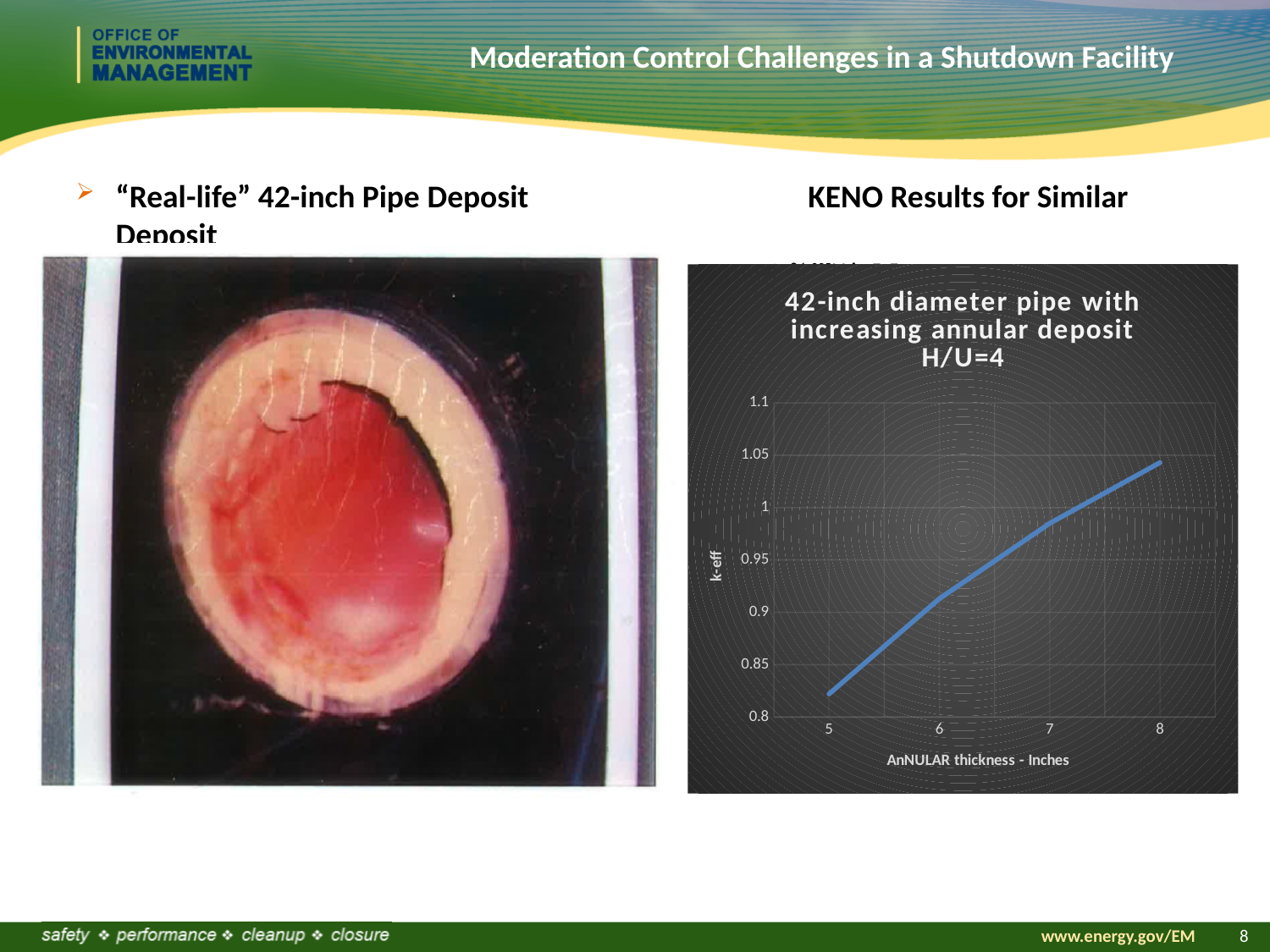
What is the label of the x axis of the chart? AnNULAR thickness - Inches Which annular thickness has the higher k-eff, 5 inches or 8 inches? 8 inches Is the k-eff value at an annular thickness of 8 inches greater or less than 1? greater What kind of chart is shown on the slide? line chart What is the title of the chart? 42-inch diameter pipe with increasing annular deposit H/U=4 Is the k-eff value at an annular thickness of 7 inches greater or less than 0.95? greater Does k-eff rise or fall as annular thickness increases from 5 to 8 inches? rise Is the k-eff value at an annular thickness of 5 inches greater or less than 0.85? less At which annular thickness shown on the x axis is k-eff highest? 8 inches What is the highest value shown on the y axis of the chart? 1.1 At which annular thickness shown on the x axis is k-eff lowest? 5 inches